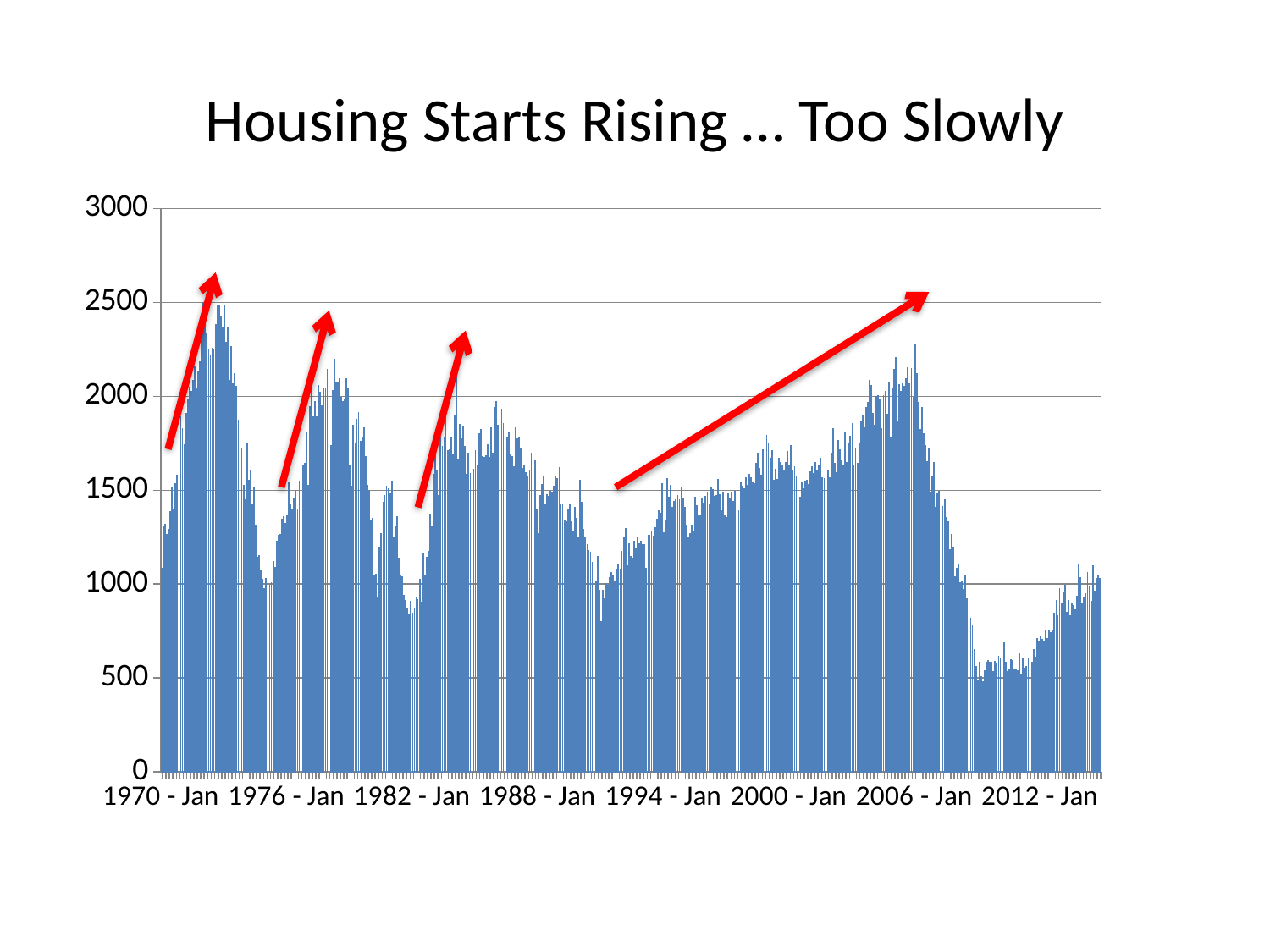
What is the title of the chart? Housing Starts Rising … Too Slowly Which is larger, the value for 1970 - Jan or the value for 2012 - Jan? 1970 - Jan Which is larger, the value for 2006 - Jan or the value for 1994 - Jan? 2006 - Jan Is the value for 2000 - Jan greater or less than 1500? greater How many date labels are shown along the x axis? 8 Is the value for 2012 - Jan greater or less than 1000? less How many red arrows are drawn on the chart? 4 Is the value for 1970 - Jan greater or less than 1000? greater What kind of chart is shown on the slide? bar chart Do the values rise or fall between 2006 - Jan and 2012 - Jan? fall